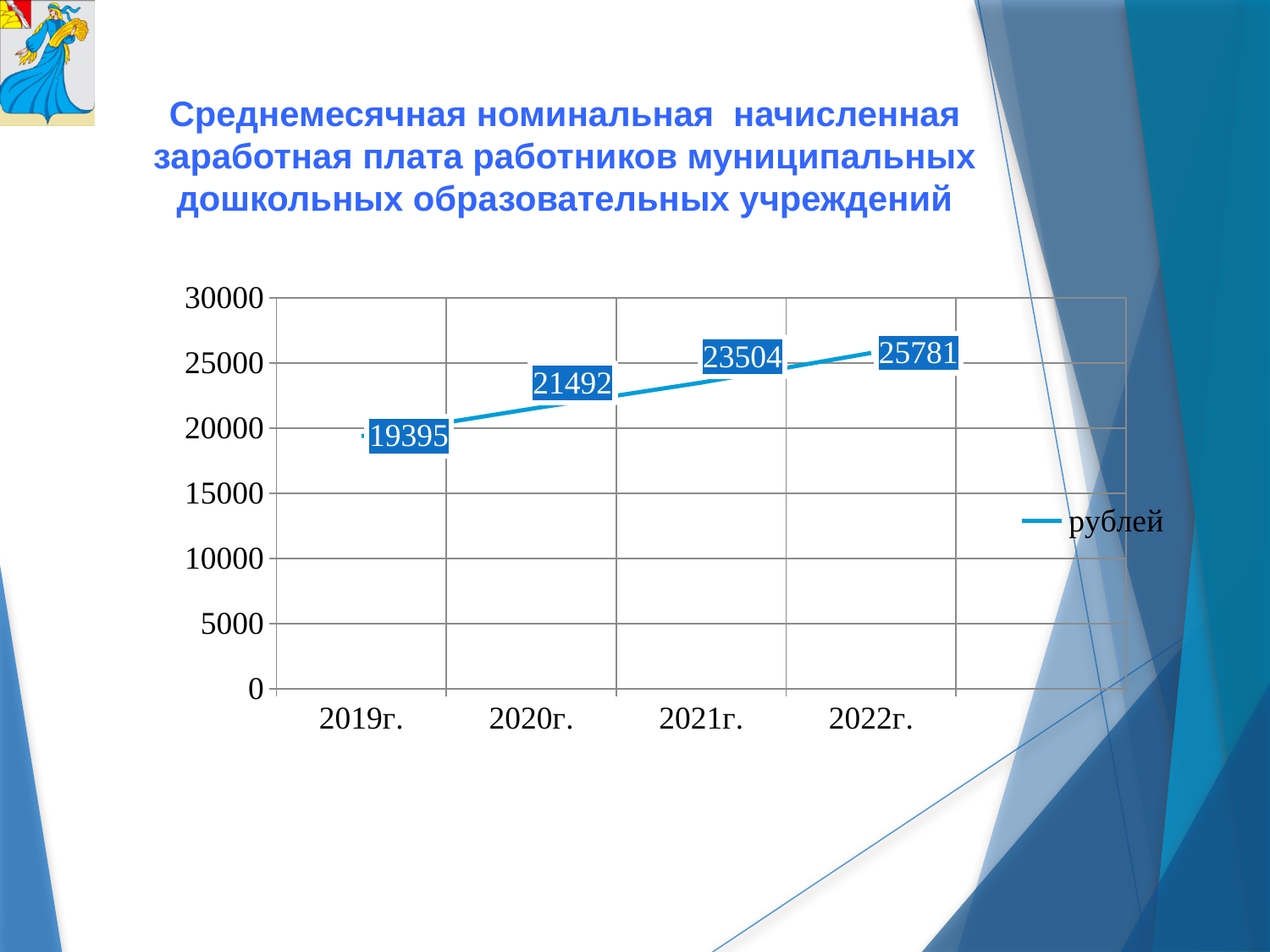
How many years are plotted on the chart? 4 What is the difference between the values for 2022г. and 2019г.? 6386 What is the value for 2021г.? 23504 What kind of chart is shown on the slide? line chart Which is larger, the value for 2020г. or the value for 2021г.? 2021г. What is the value for 2019г.? 19395 Which year has the lowest value? 2019г. Do the values rise or fall from 2019г. to 2022г.? rise Which year has the highest value? 2022г. What is the difference between the values for 2021г. and 2020г.? 2012 Is the value for 2022г. greater or less than 25000? greater What is the value for 2022г.? 25781